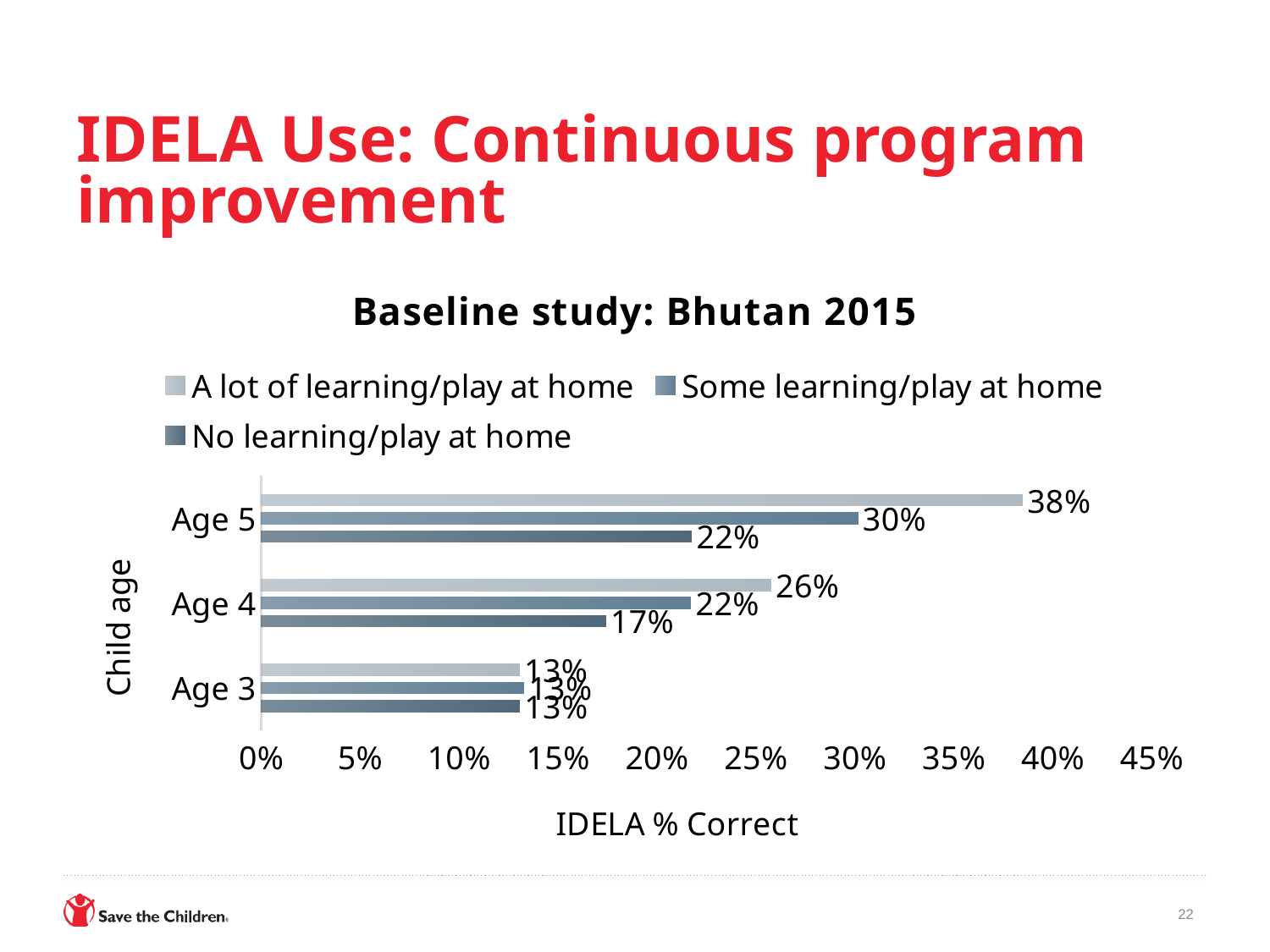
What is the IDELA % Correct for Age 5 children with a lot of learning/play at home? 38% How many child age categories are shown on the chart? 3 How many series does the legend list? 3 What kind of chart is shown on the slide? Bar chart What is the IDELA % Correct for Age 5 children with some learning/play at home? 30% Which child age has the highest IDELA % Correct for the 'A lot of learning/play at home' series? Age 5 Is the IDELA % Correct for Age 5 children with some learning/play at home greater or less than 25%? greater What is the title of the chart? Baseline study: Bhutan 2015 What is the IDELA % Correct for Age 4 children with no learning/play at home? 17% Which is larger: the IDELA % Correct for Age 4 with a lot of learning/play at home, or for Age 5 with no learning/play at home? Age 4 with a lot of learning/play at home What is the difference in IDELA % Correct between Age 5 children with a lot of learning/play at home and those with no learning/play at home? 16% Which child age has the lowest IDELA % Correct for the 'Some learning/play at home' series? Age 3